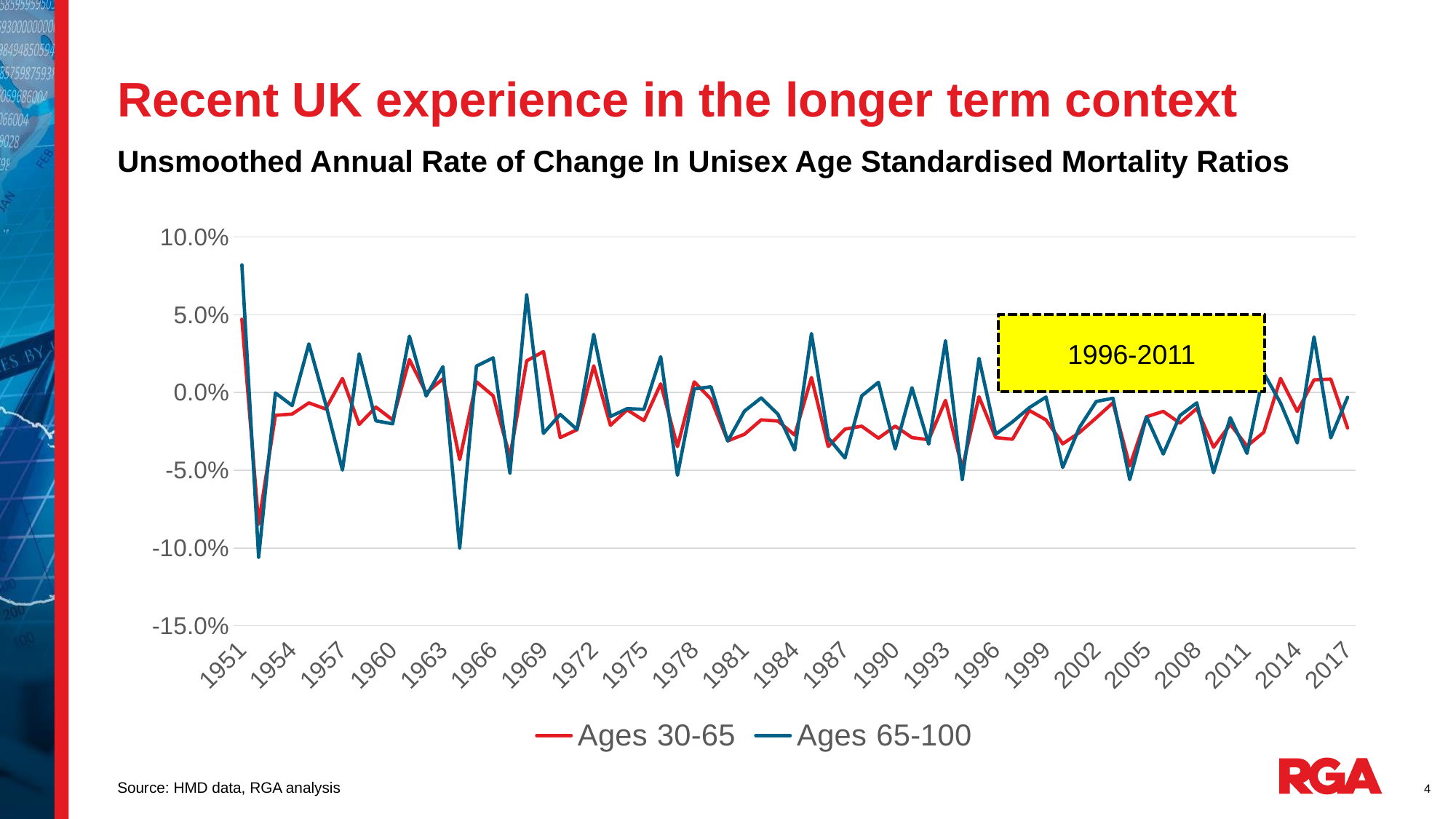
In 1951, which series has the higher value, Ages 30-65 or Ages 65-100? Ages 65-100 Which series reaches the highest value anywhere on the chart? Ages 65-100 How many year labels are shown on the x axis? 23 Is the value for Ages 30-65 in 1951 greater or less than 0.0%? greater In 1952, which series has the lower value, Ages 30-65 or Ages 65-100? Ages 65-100 What kind of chart is shown on the slide? Line chart Is the value for Ages 65-100 in 1964 greater or less than -5.0%? less What period is highlighted by the yellow box on the chart? 1996-2011 Is the value for Ages 65-100 in 1951 greater or less than 5.0%? greater What are the two series named in the legend? Ages 30-65 and Ages 65-100 How many series does the legend list? 2